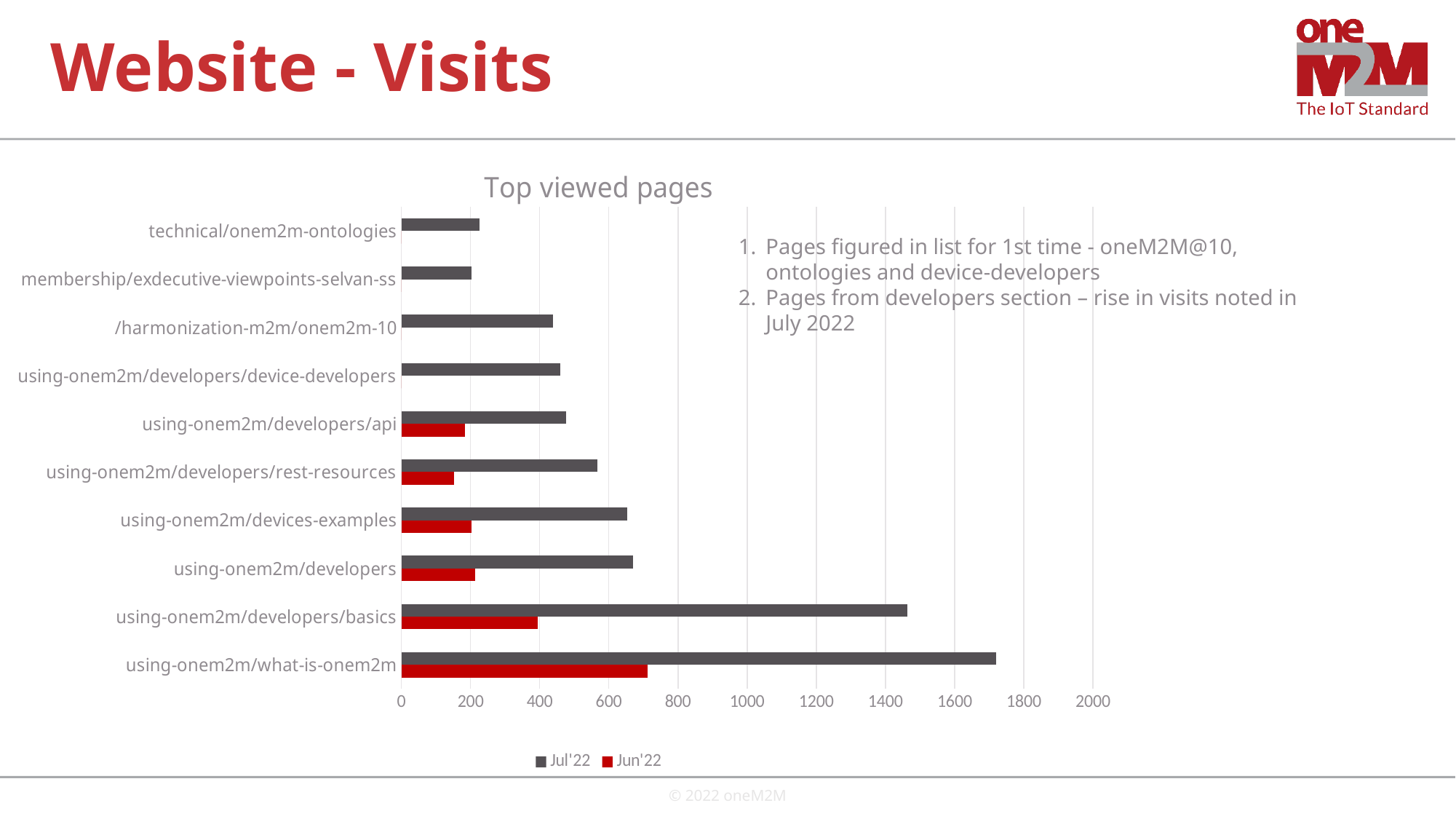
Which is larger: the Jul'22 value for using-onem2m/developers/basics or the Jul'22 value for using-onem2m/developers? using-onem2m/developers/basics What kind of chart is shown on the slide? bar chart How many series does the chart's legend list? 2 Is the Jul'22 value for using-onem2m/developers/rest-resources greater or less than 600? less How many pages (categories) are plotted in the chart? 10 Which page has the highest Jul'22 value? using-onem2m/what-is-onem2m Is the Jun'22 value for using-onem2m/what-is-onem2m greater or less than 600? greater Which series is shown in red in the chart? Jun'22 What is the title of the chart? Top viewed pages Which page has the highest Jun'22 value? using-onem2m/what-is-onem2m Is the Jul'22 value for using-onem2m/what-is-onem2m greater or less than 1600? greater